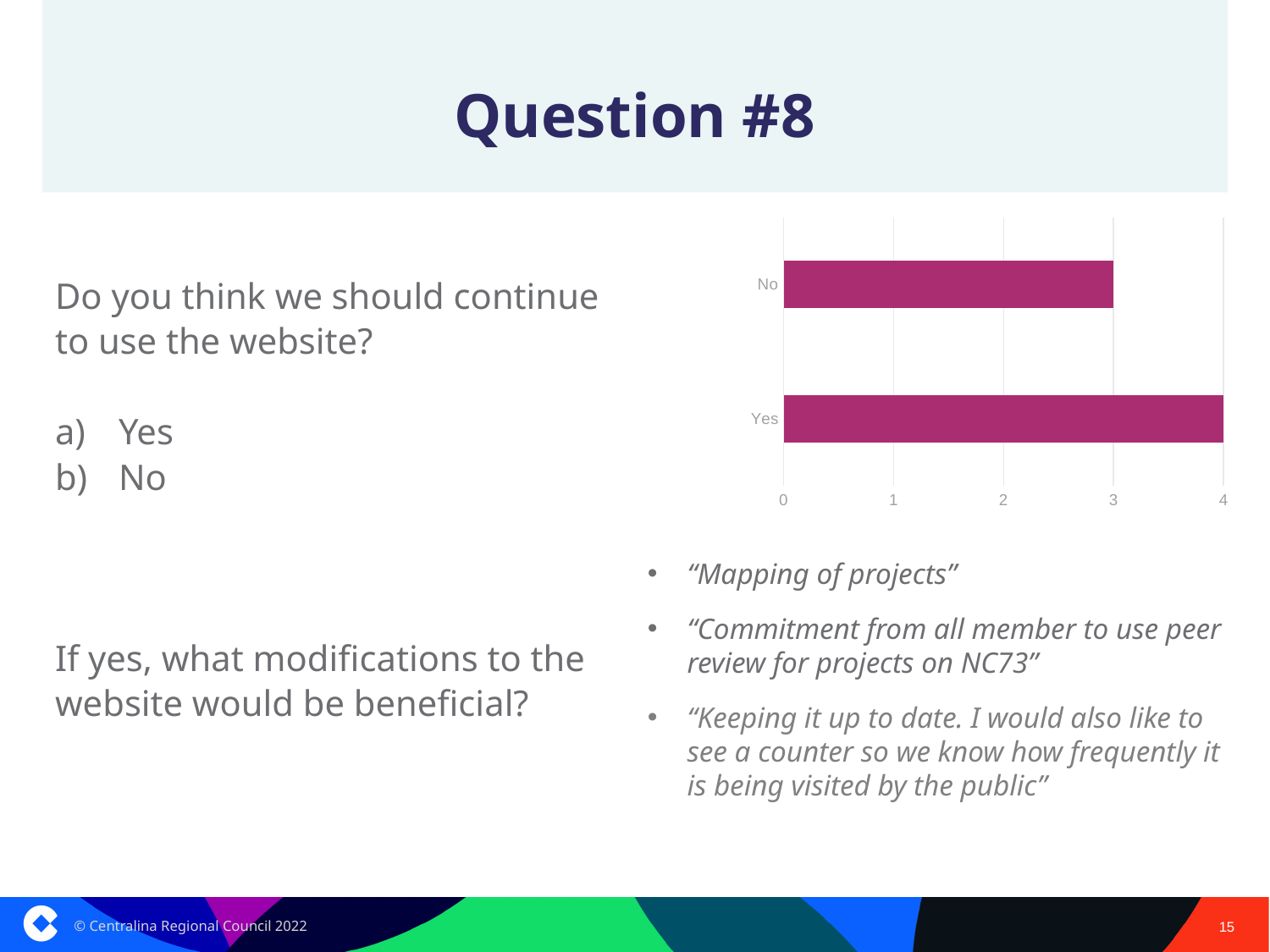
What is the maximum value shown on the horizontal axis? 4 What colour are the bars in the chart? magenta What is the value for Yes? 4 Which category has the highest value? Yes What is the difference between the values for Yes and No? 1 Which category has the lowest value? No What is the value for No? 3 How many categories does the chart show? 2 Is the value for No greater or less than 2? greater Which is larger, the value for Yes or the value for No? Yes What type of chart is shown on the slide? bar chart